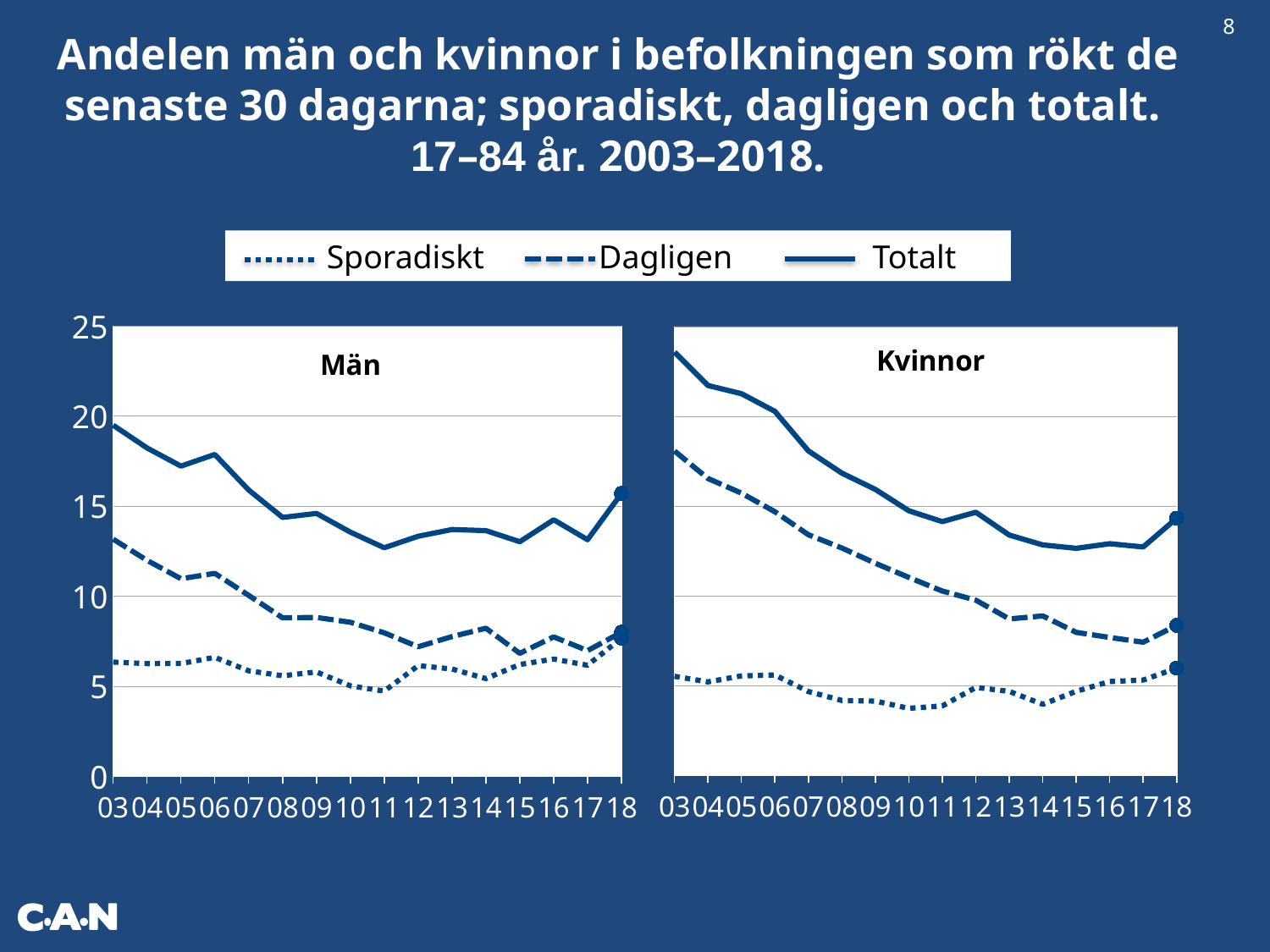
Which line style does the legend use for Sporadiskt? dotted In the "Män" chart, which year has the highest value for Totalt? 03 How many years are shown on the x axis of the "Kvinnor" chart? 16 In the "Kvinnor" chart, is the value for Dagligen in 18 greater or less than 10? less Which is larger in 03: Totalt in the "Män" chart or Totalt in the "Kvinnor" chart? Kvinnor In the "Kvinnor" chart, is the value for Sporadiskt in 10 greater or less than 5? less In the "Män" chart, is the value for Dagligen in 03 greater or less than 10? greater In the "Kvinnor" chart, does the Totalt series generally rise or fall from 03 to 18? fall What kind of chart is the "Män" chart? line chart In the "Kvinnor" chart, which year has the highest value for Dagligen? 03 How many series does the legend list? 3